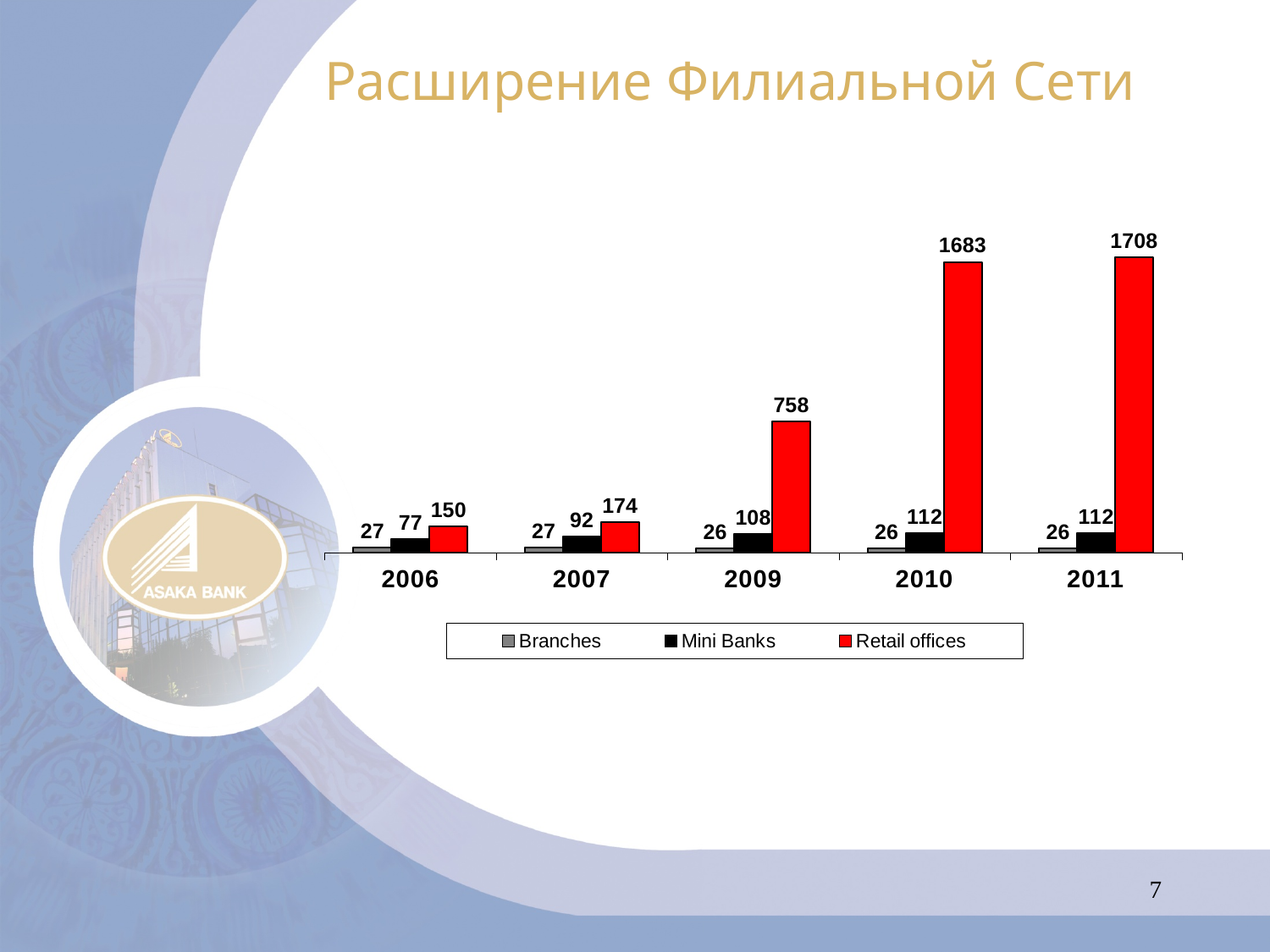
In which year is the Mini Banks value lowest? 2006 What kind of chart is shown on the slide? bar chart In which year is the Retail offices value highest? 2011 What is the difference between the Retail offices values for 2011 and 2010? 25 What is the value for Branches in 2011? 26 What is the value for Mini Banks in 2007? 92 What is the difference between the Mini Banks values for 2009 and 2006? 31 How many series does the legend list? 3 What is the value for Retail offices in 2009? 758 Do the Retail offices values rise or fall from 2006 to 2011? rise Which is larger, the Retail offices value for 2007 or for 2006? 2007 How many years are shown on the x axis? 5